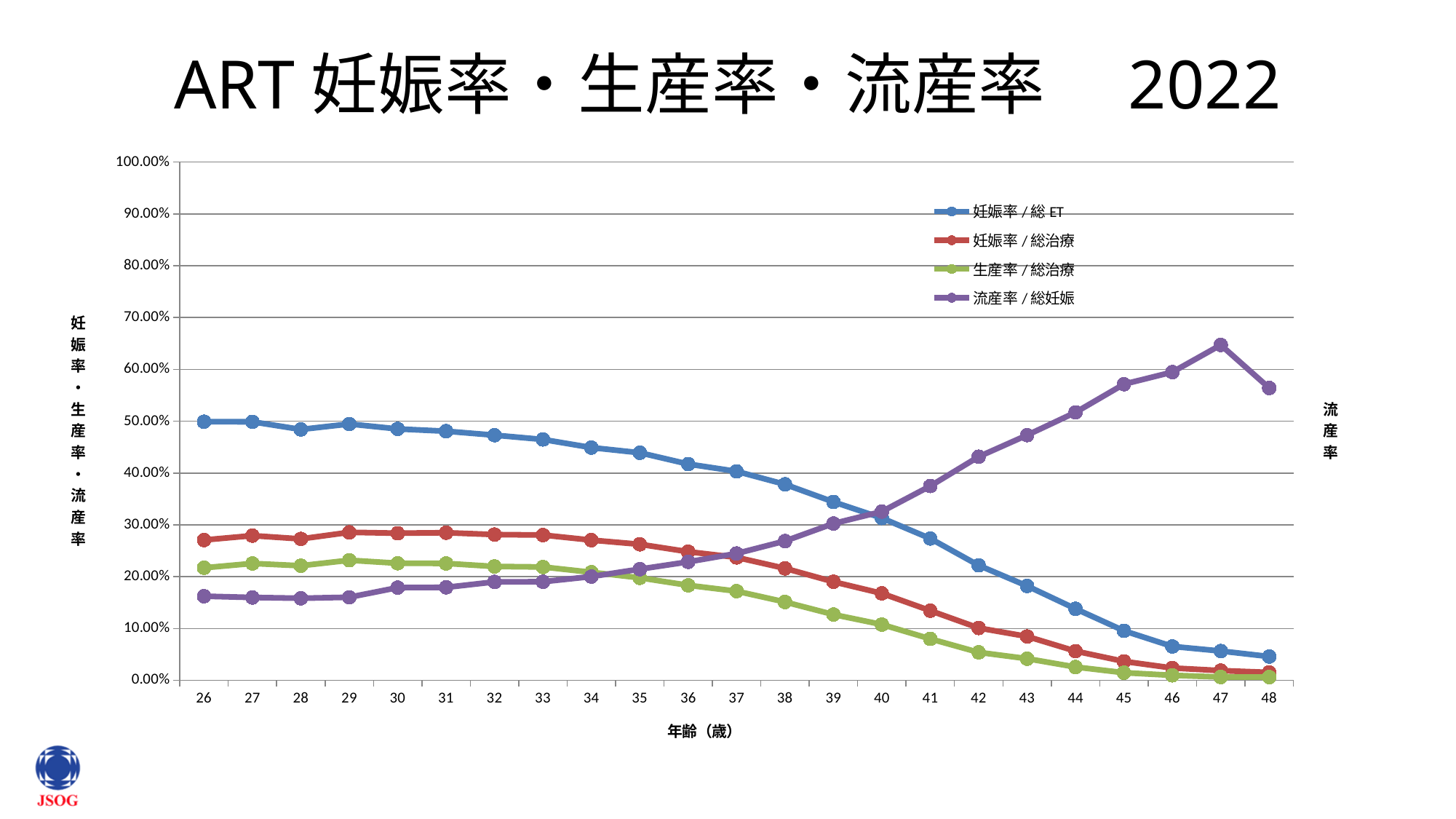
How many series does the legend list? 4 Is the value of 流産率 / 総妊娠 at age 47 greater or less than 60.00%? greater Is the value of 妊娠率 / 総 ET at age 36 greater or less than 40.00%? greater What kind of chart is shown on the slide? line chart What is the label of the x axis? 年齢（歳） Is the value of 生産率 / 総治療 at age 45 greater or less than 10.00%? less At which age does the 流産率 / 総妊娠 series reach its highest value? 47 At age 41, which is larger: 流産率 / 総妊娠 or 妊娠率 / 総 ET? 流産率 / 総妊娠 At which age is the 妊娠率 / 総 ET series at its lowest value? 48 Does the 妊娠率 / 総 ET series rise or fall as age increases from 26 to 48? fall How many age points are plotted along the x axis? 23